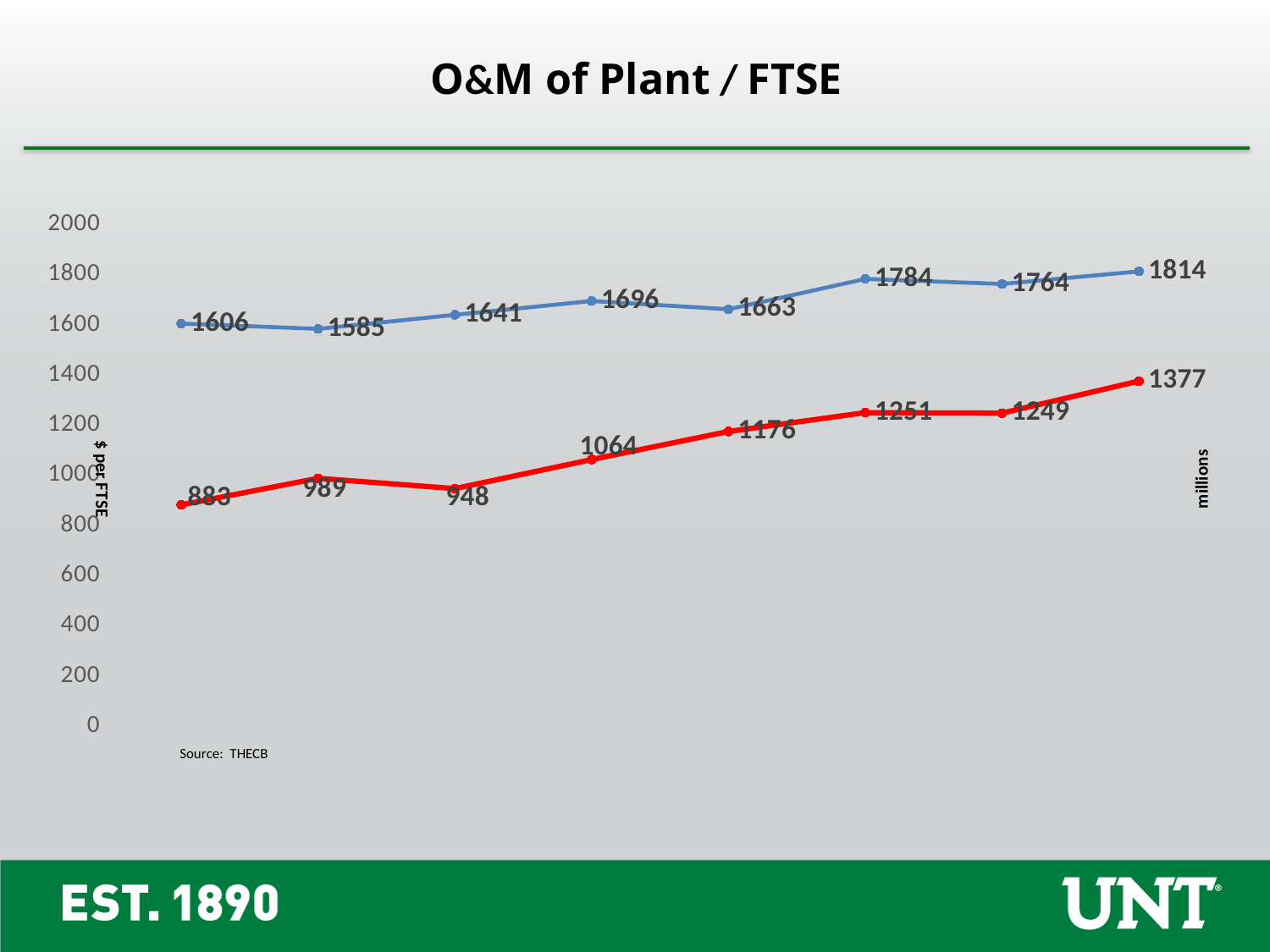
What is the difference between the last and first values on the red line (1377 and 883)? 494 What is the highest value labeled on the blue line? 1814 What is the value of the first point on the blue line? 1606 What kind of chart is shown on the slide? line chart How many data points are plotted on the blue line? 8 What is the value of the fourth point on the red line? 1064 Overall, do the values on the red line rise or fall from left to right? rise What is the title of the chart? O&M of Plant / FTSE Which line has the higher value at the last point, the blue line or the red line? blue line What is the value of the last point on the red line? 1377 What is the lowest value labeled on the red line? 883 What is the difference between the last and first values on the blue line (1814 and 1606)? 208